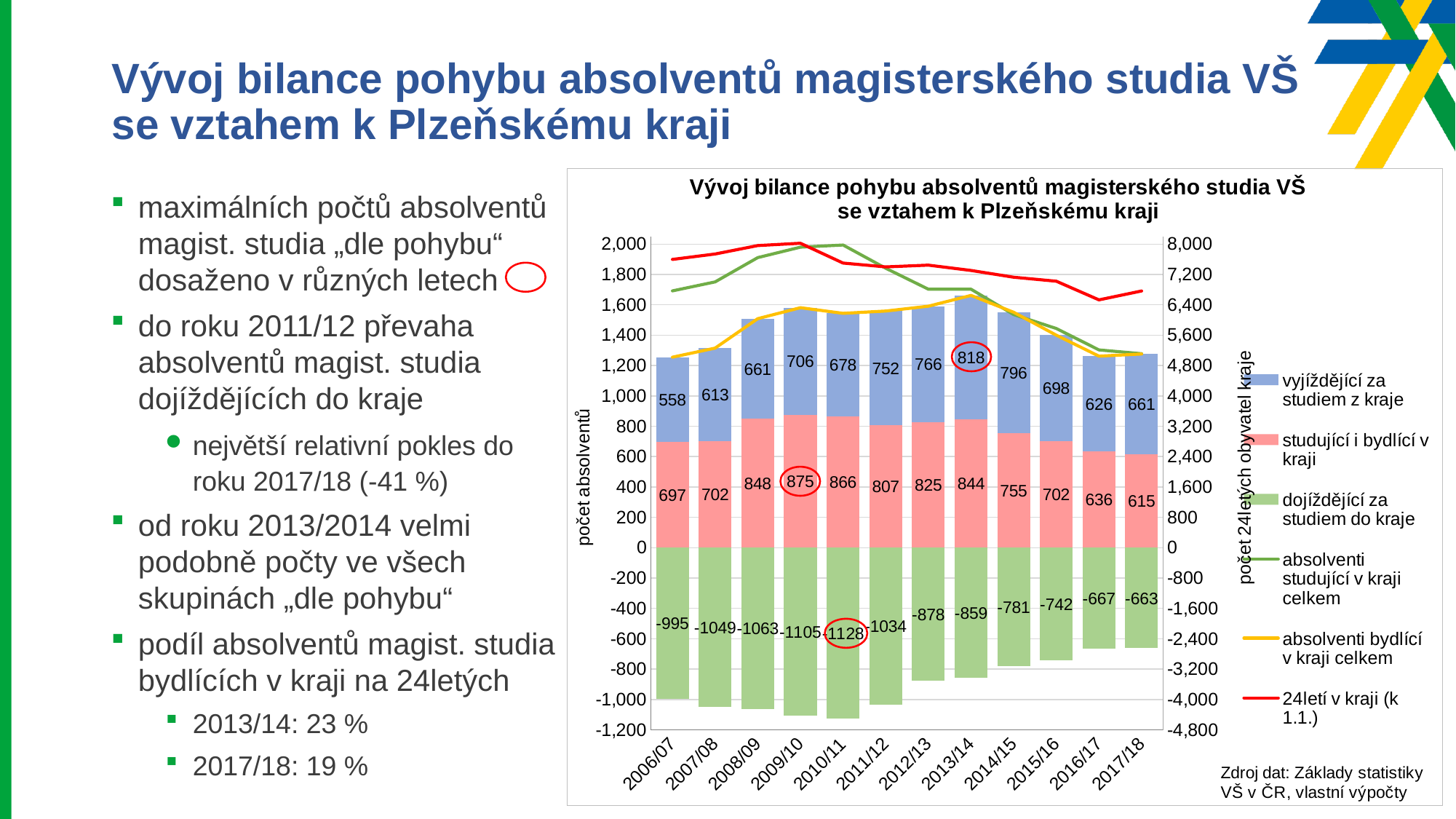
Does the red line '24letí v kraji (k 1.1.)' generally rise or fall from 2009/10 to 2016/17? fall What is the value for 'dojíždějící za studiem do kraje' in 2010/11? -1128 What is the value for 'vyjíždějící za studiem z kraje' in 2013/14? 818 Which is larger: 'studující i bydlící v kraji' in 2008/09 or in 2011/12? 2008/09 In which year is the 'studující i bydlící v kraji' series lowest? 2017/18 What is the value for 'studující i bydlící v kraji' in 2009/10? 875 What kind of chart is this? Stacked bar chart with line series How many series does the legend list? 6 What is the label of the right-hand vertical axis? počet 24letých obyvatel kraje In which year is the 'vyjíždějící za studiem z kraje' series highest? 2013/14 What is the difference between the 'vyjíždějící za studiem z kraje' values in 2013/14 and 2006/07? 260 How many academic years are shown on the x axis? 12